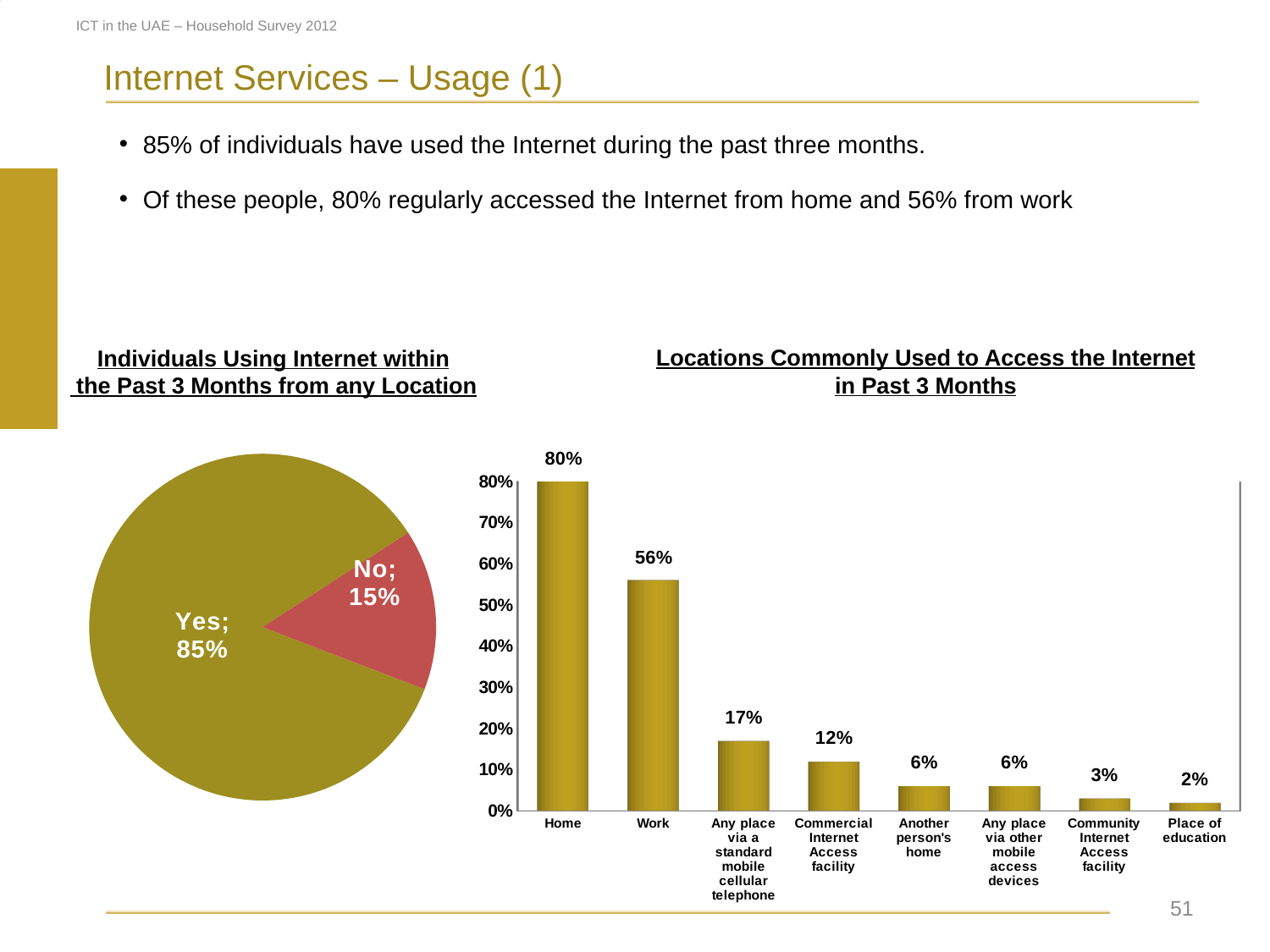
In the 'Locations Commonly Used to Access the Internet in Past 3 Months' chart, which is larger: Any place via a standard mobile cellular telephone or Community Internet Access facility? Any place via a standard mobile cellular telephone In the 'Individuals Using Internet within the Past 3 Months from any Location' chart, what share of individuals answered No? 15% In the 'Individuals Using Internet within the Past 3 Months from any Location' chart, what share of individuals answered Yes? 85% What kind of chart is 'Individuals Using Internet within the Past 3 Months from any Location'? Pie chart In the 'Locations Commonly Used to Access the Internet in Past 3 Months' chart, which location has the highest value? Home In the 'Locations Commonly Used to Access the Internet in Past 3 Months' chart, do the values rise or fall from left to right? Fall How many locations are shown in the 'Locations Commonly Used to Access the Internet in Past 3 Months' chart? 8 In the 'Locations Commonly Used to Access the Internet in Past 3 Months' chart, what is the value for Work? 56% What kind of chart is 'Locations Commonly Used to Access the Internet in Past 3 Months'? Bar chart In the 'Locations Commonly Used to Access the Internet in Past 3 Months' chart, which location has the lowest value? Place of education In the 'Locations Commonly Used to Access the Internet in Past 3 Months' chart, what is the value for Commercial Internet Access facility? 12% In the 'Locations Commonly Used to Access the Internet in Past 3 Months' chart, what is the difference between the values for Home and Work? 24%